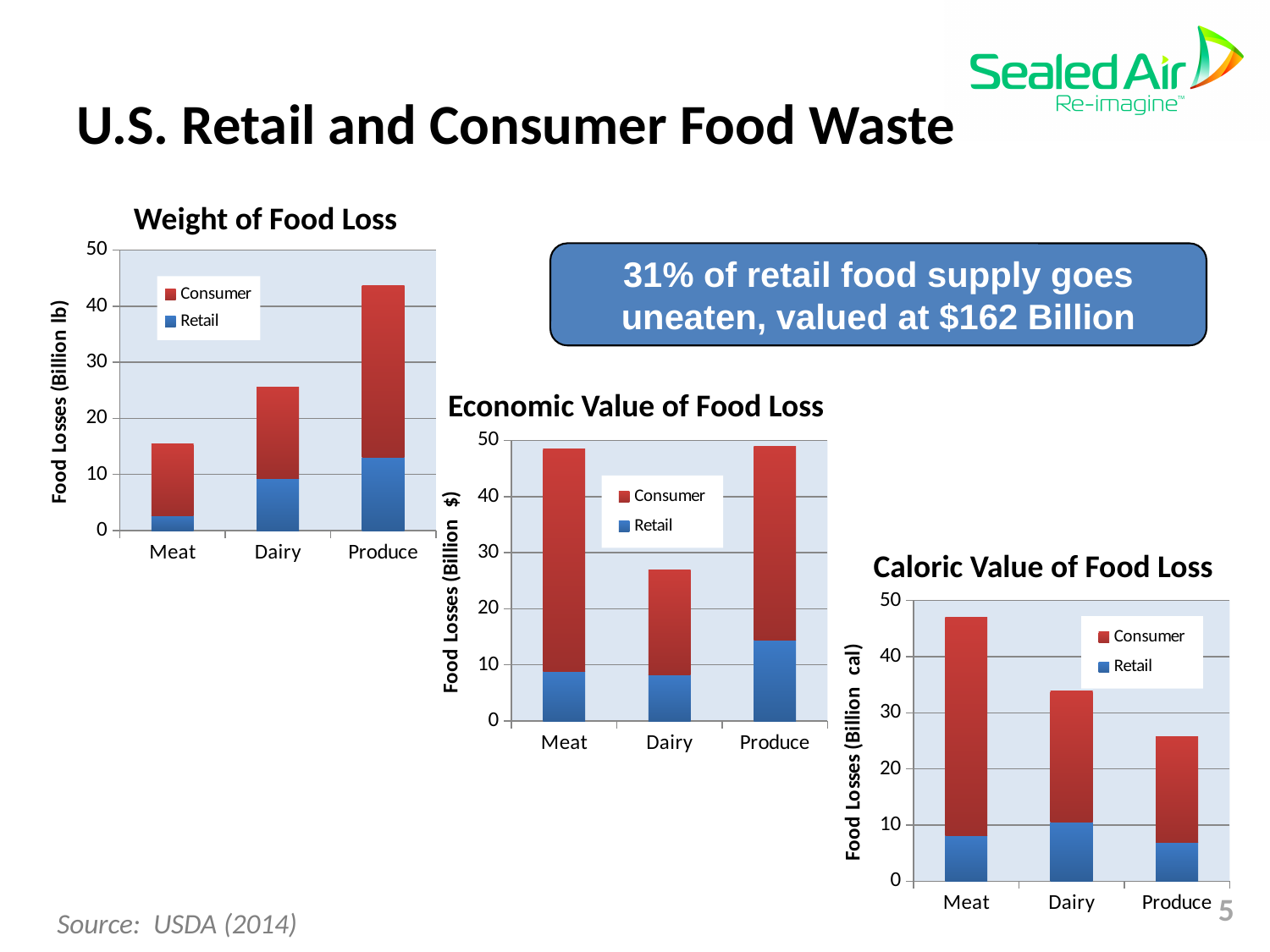
In the Weight of Food Loss chart, is the total value for Produce greater or less than 40? greater In the Weight of Food Loss chart, is the total value for Meat greater or less than 20? less In the Caloric Value of Food Loss chart, is the total value for Produce greater or less than 30? less In the Weight of Food Loss chart, which category has the tallest total bar? Produce In the Caloric Value of Food Loss chart, which is larger in total, Dairy or Produce? Dairy In the Weight of Food Loss chart, which category has the shortest total bar? Meat How many series does the legend of the Caloric Value of Food Loss chart list? 2 In the Economic Value of Food Loss chart, which category has the lowest total bar? Dairy What kind of chart is the Weight of Food Loss chart? Stacked bar chart In the Caloric Value of Food Loss chart, which category has the tallest total bar? Meat